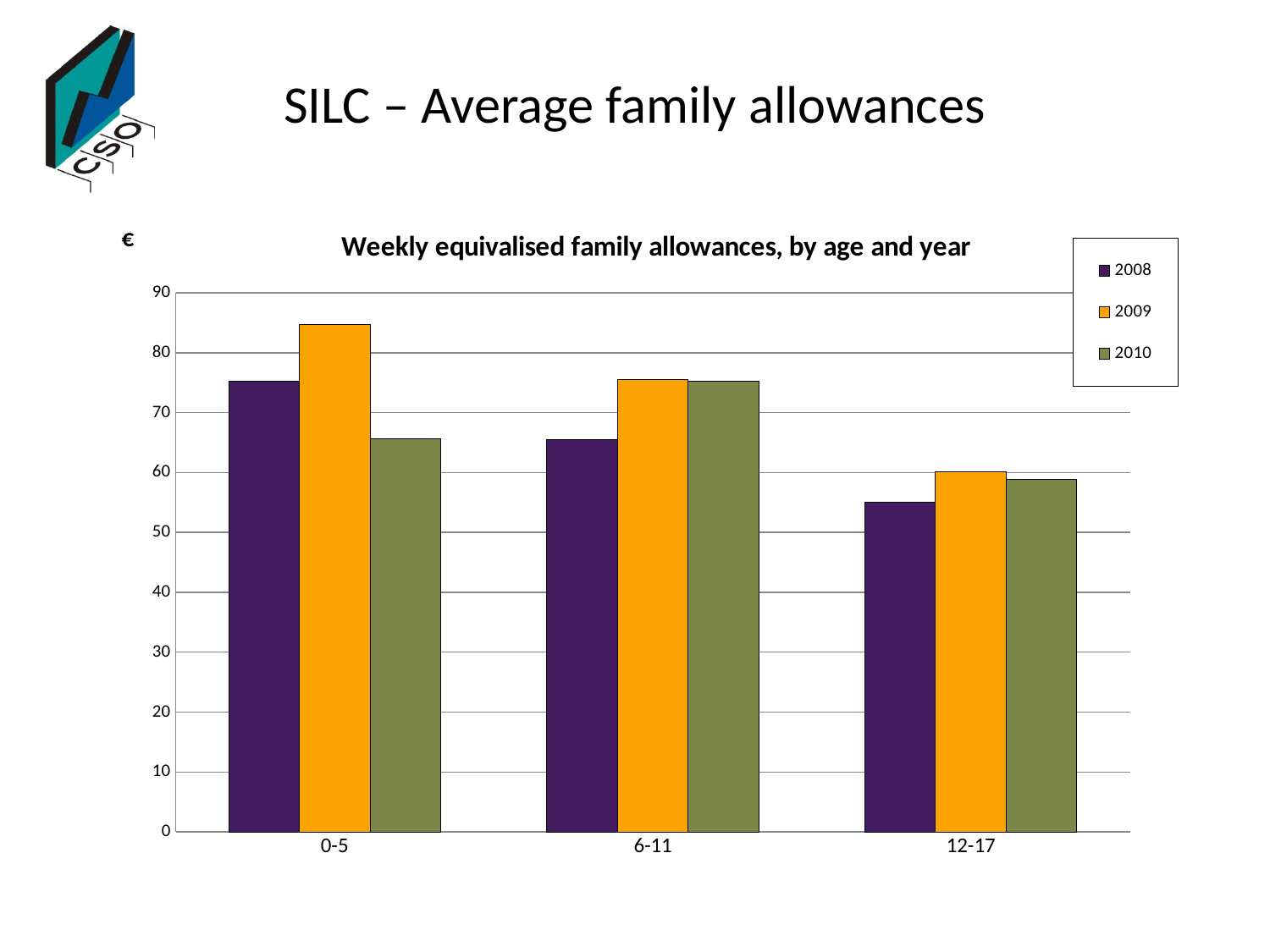
Is the value for 2009 in the 0-5 age group greater or less than 80? greater How many series does the legend list? 3 In the 6-11 age group, which year has the larger value, 2008 or 2009? 2009 Is the value for 2008 in the 12-17 age group greater or less than 60? less What is the title of the chart? Weekly equivalised family allowances, by age and year Is the value for 2010 in the 0-5 age group greater or less than 70? less In the 0-5 age group, which year has the larger value, 2008 or 2010? 2008 Do the 2008 values rise or fall as the age groups go from 0-5 to 12-17? fall Which age group has the lowest bar for 2008? 12-17 Which age group has the highest bar for 2009? 0-5 How many age groups are shown on the x axis? 3 What kind of chart is shown on the slide? Bar chart